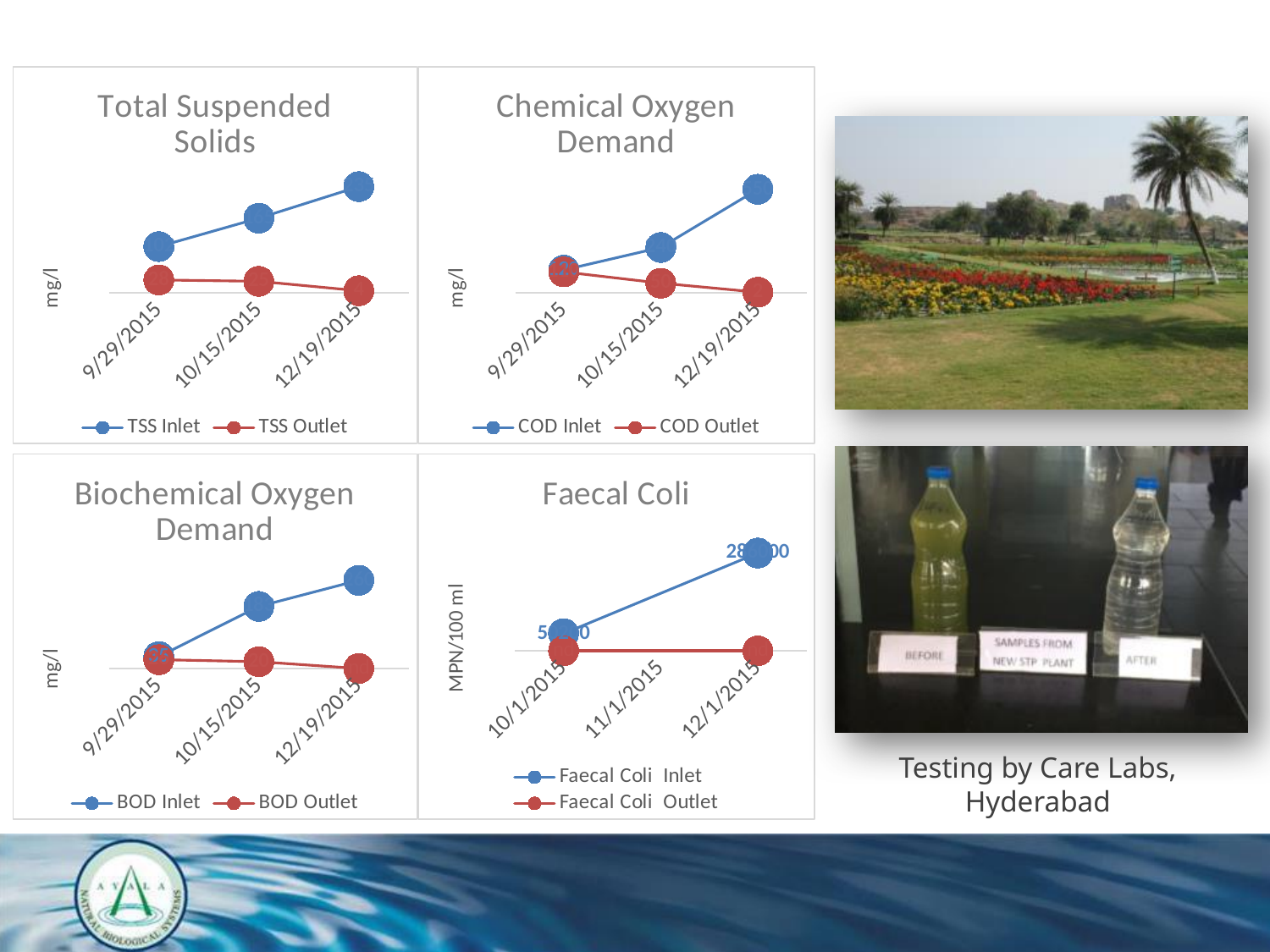
In the Biochemical Oxygen Demand chart, which is larger on 12/19/2015, BOD Inlet or BOD Outlet? BOD Inlet What kind of chart is the Total Suspended Solids chart? line chart What are the two legend entries of the Biochemical Oxygen Demand chart? BOD Inlet, BOD Outlet How many dates are plotted on the x axis of the Biochemical Oxygen Demand chart? 3 In the Chemical Oxygen Demand chart, on which date is the COD Inlet value lowest? 9/29/2015 In the Chemical Oxygen Demand chart, does the COD Outlet series rise or fall across the dates? fall In the Total Suspended Solids chart, on which date is the TSS Inlet value highest? 12/19/2015 In the Total Suspended Solids chart, does the TSS Inlet series rise or fall from 9/29/2015 to 12/19/2015? rise What is the y-axis unit label on the Faecal Coli chart? MPN/100 ml In the Faecal Coli chart, does the Faecal Coli Inlet series rise or fall from 10/1/2015 to 12/1/2015? rise In the Faecal Coli chart, which is larger on 12/1/2015, Faecal Coli Inlet or Faecal Coli Outlet? Faecal Coli Inlet How many series does the legend of the Chemical Oxygen Demand chart list? 2